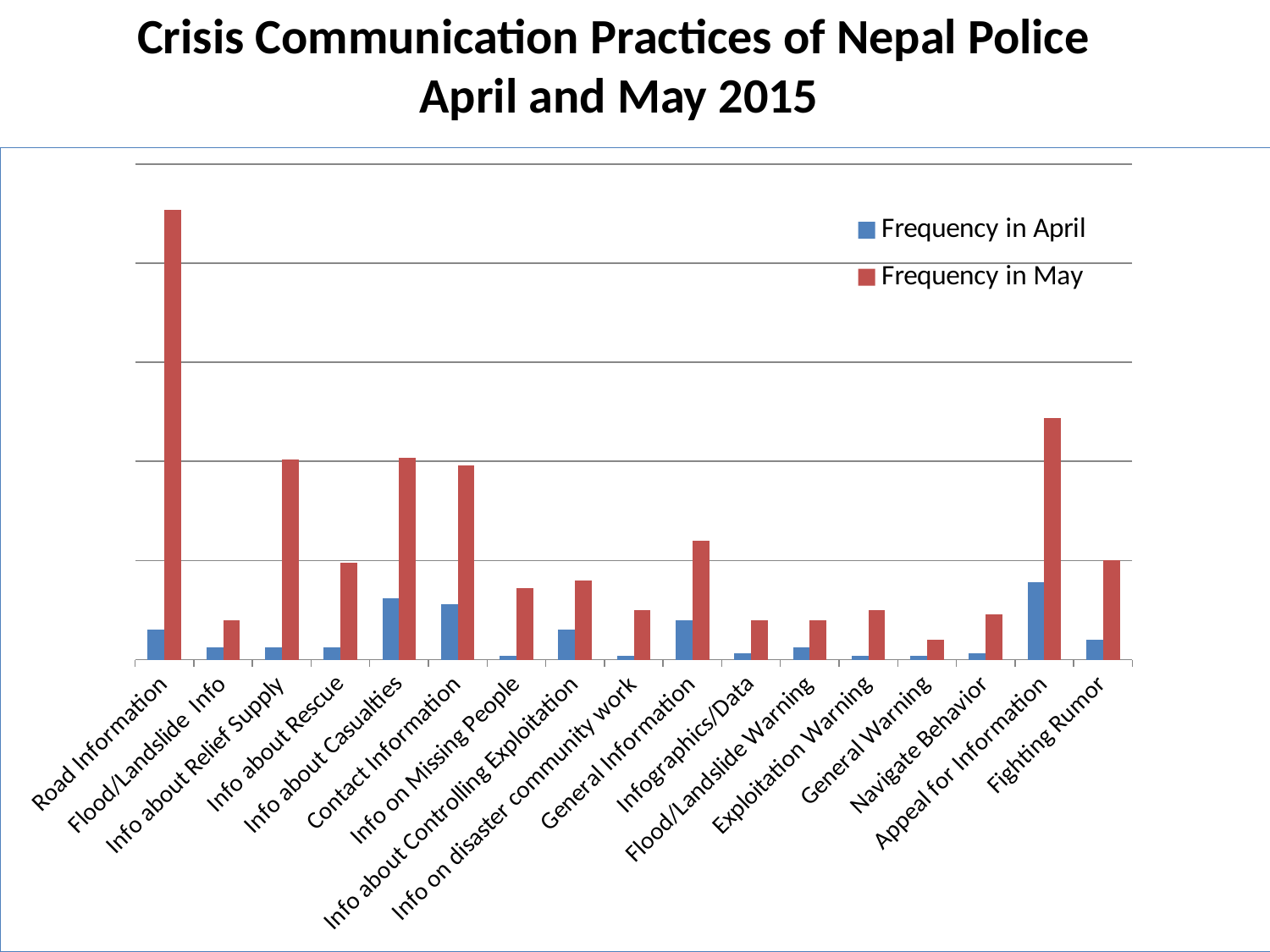
Which category has the lowest Frequency in May? General Warning For Road Information, which is larger: Frequency in April or Frequency in May? Frequency in May Which has the larger Frequency in May: Info about Relief Supply or Info about Rescue? Info about Relief Supply Which category has the highest Frequency in May? Road Information What colour are the bars for Frequency in May? red What kind of chart is shown on the slide? bar chart What are the two series named in the legend? Frequency in April and Frequency in May Which category has the highest Frequency in April? Appeal for Information Which has the larger Frequency in April: Appeal for Information or Info about Casualties? Appeal for Information How many categories are shown along the x axis? 17 How many series does the legend list? 2